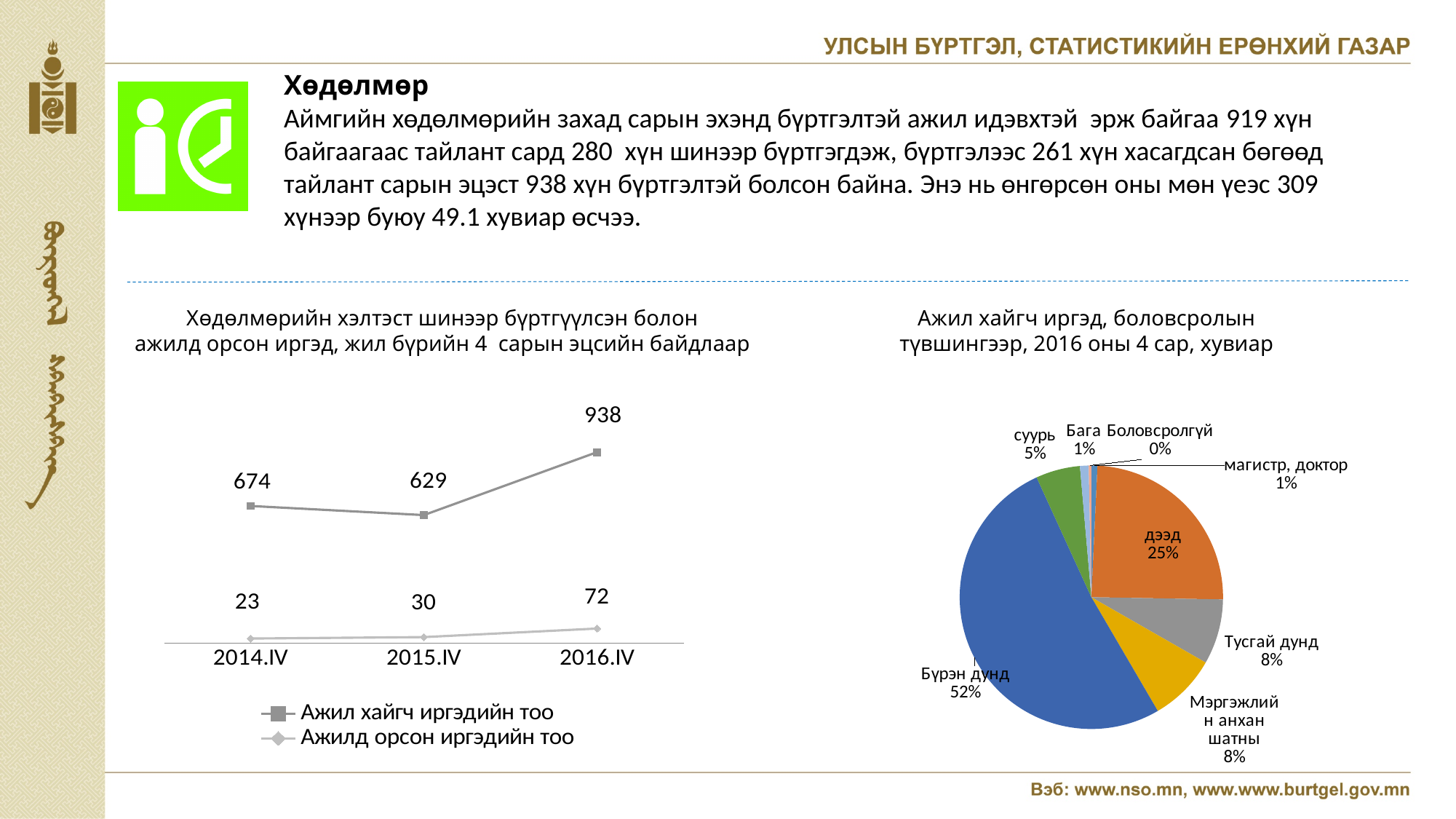
In the right pie chart, which category has the largest share? Бүрэн дунд In the left chart, which period has the lowest value for Ажил хайгч иргэдийн тоо? 2015.IV In the left chart, how many periods are shown on the x axis? 3 In the right pie chart, how many slices are labelled? 8 In the left chart, how many series does the legend list? 2 In the right pie chart, what share does Бүрэн дунд have? 52% In the right pie chart, what is the share for дээд? 25% In the left chart, what is the value of Ажилд орсон иргэдийн тоо for 2015.IV? 30 In the left chart, does Ажилд орсон иргэдийн тоо rise or fall from 2014.IV to 2016.IV? Rise What kind of chart is the left chart? Line chart In the left chart, what is the difference between Ажил хайгч иргэдийн тоо in 2016.IV and 2015.IV? 309 In the left chart, what is the value of Ажил хайгч иргэдийн тоо for 2016.IV? 938